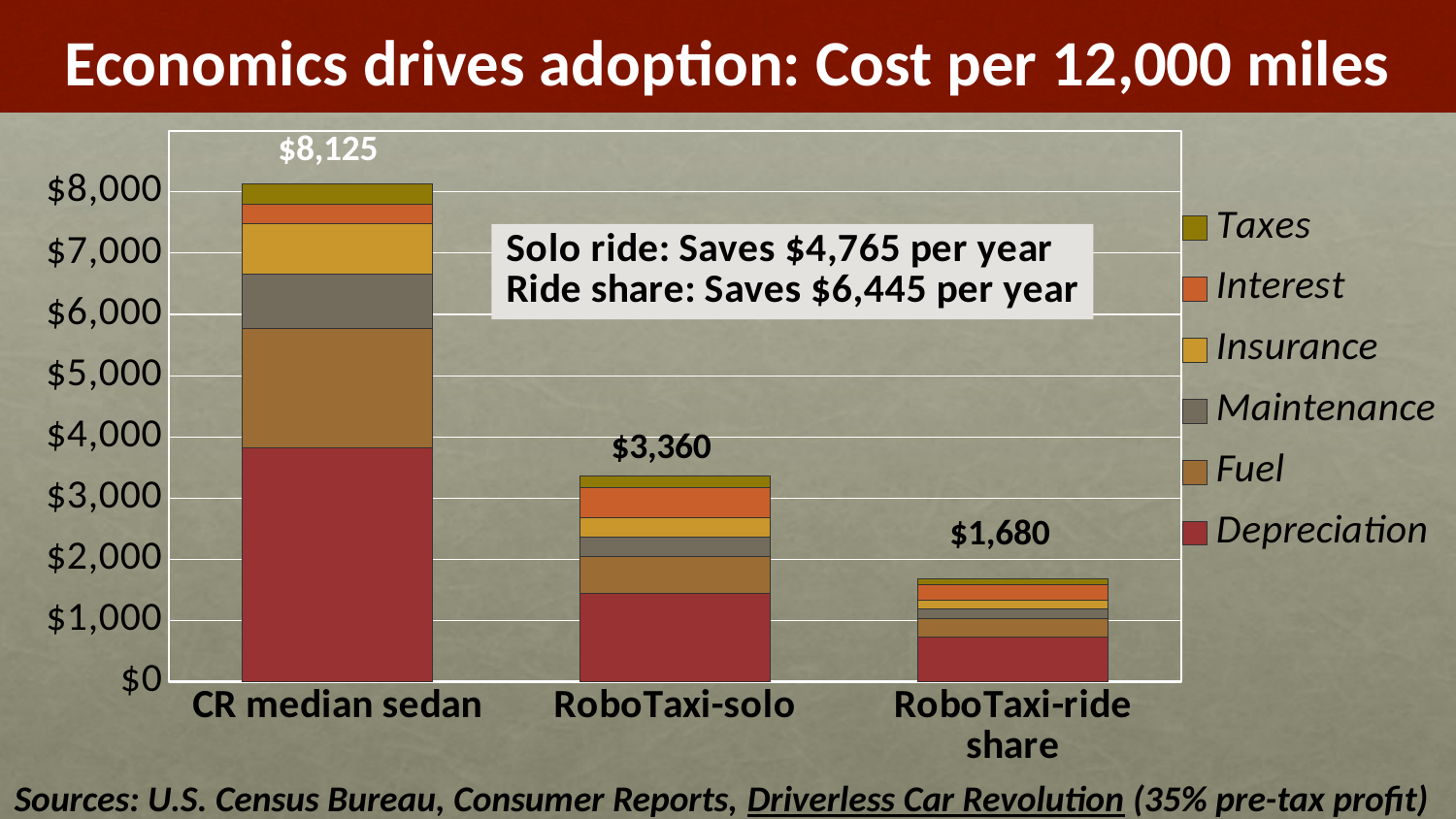
Is the Depreciation value for RoboTaxi-ride share greater or less than $1,000? less What is the total cost per 12,000 miles for the CR median sedan? $8,125 What is the difference in total cost between RoboTaxi-solo and RoboTaxi-ride share? $1,680 What kind of chart is shown on the slide? Stacked bar chart What is the total cost per 12,000 miles for RoboTaxi-solo? $3,360 Which category has the lowest total cost? RoboTaxi-ride share Which has a larger total cost, RoboTaxi-solo or RoboTaxi-ride share? RoboTaxi-solo How many series does the legend list? 6 Which category has the highest total cost? CR median sedan What is the difference in total cost between the CR median sedan and RoboTaxi-solo? $4,765 Is the Depreciation value for the CR median sedan greater or less than $3,000? greater What is the total cost per 12,000 miles for RoboTaxi-ride share? $1,680